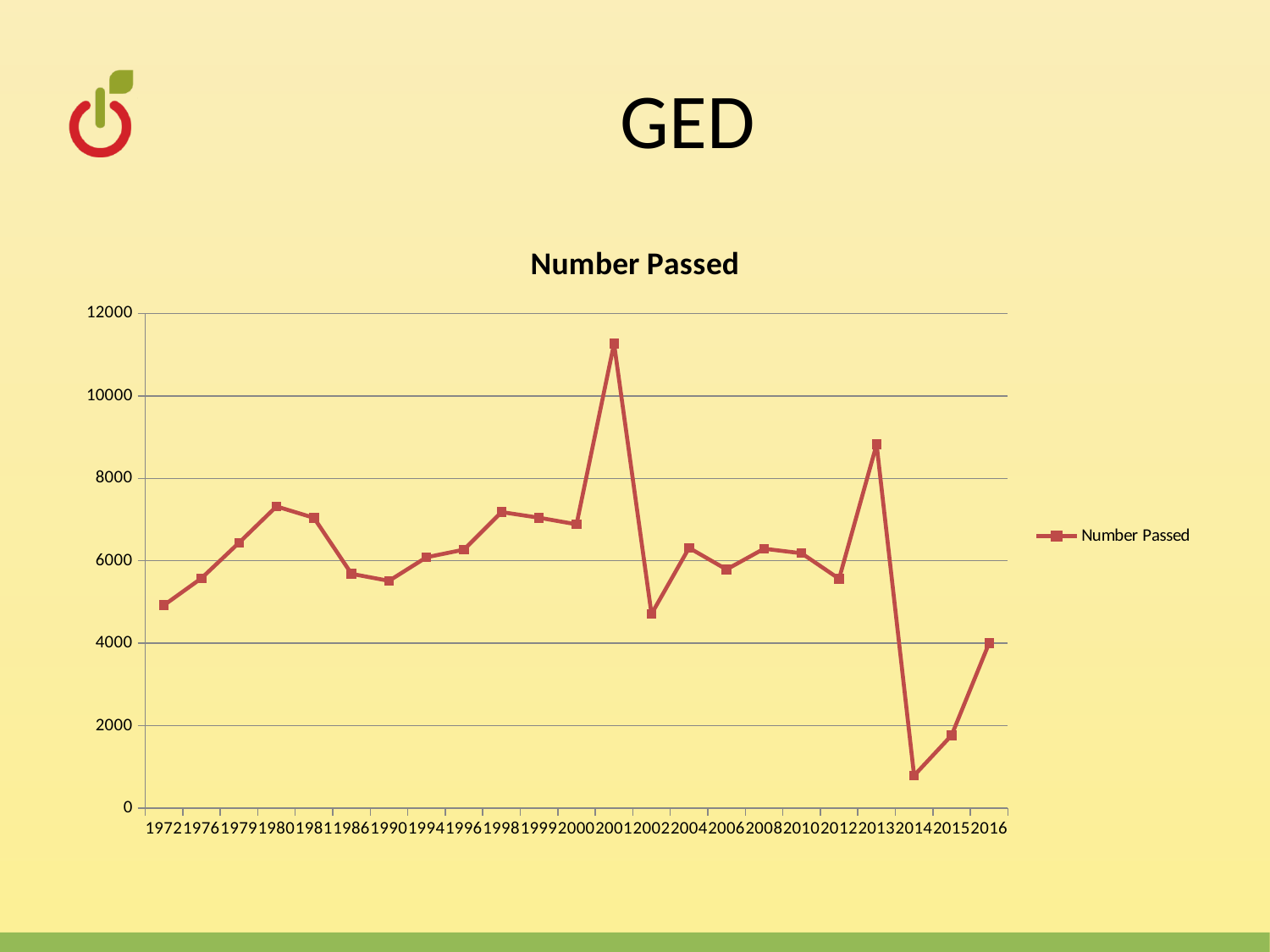
Which year has the lowest number passed? 2014 Is the value for 2014 greater or less than 2000? less Do the values rise or fall from 2013 to 2014? fall What is the title of the chart? Number Passed What kind of chart is shown on the slide? line chart Which year has the highest number passed? 2001 Which year has a larger number passed, 2001 or 2013? 2001 Is the value for 2001 greater or less than 10000? greater Is the value for 2013 greater or less than 8000? greater How many years are plotted along the x axis? 23 How many series does the legend list? 1